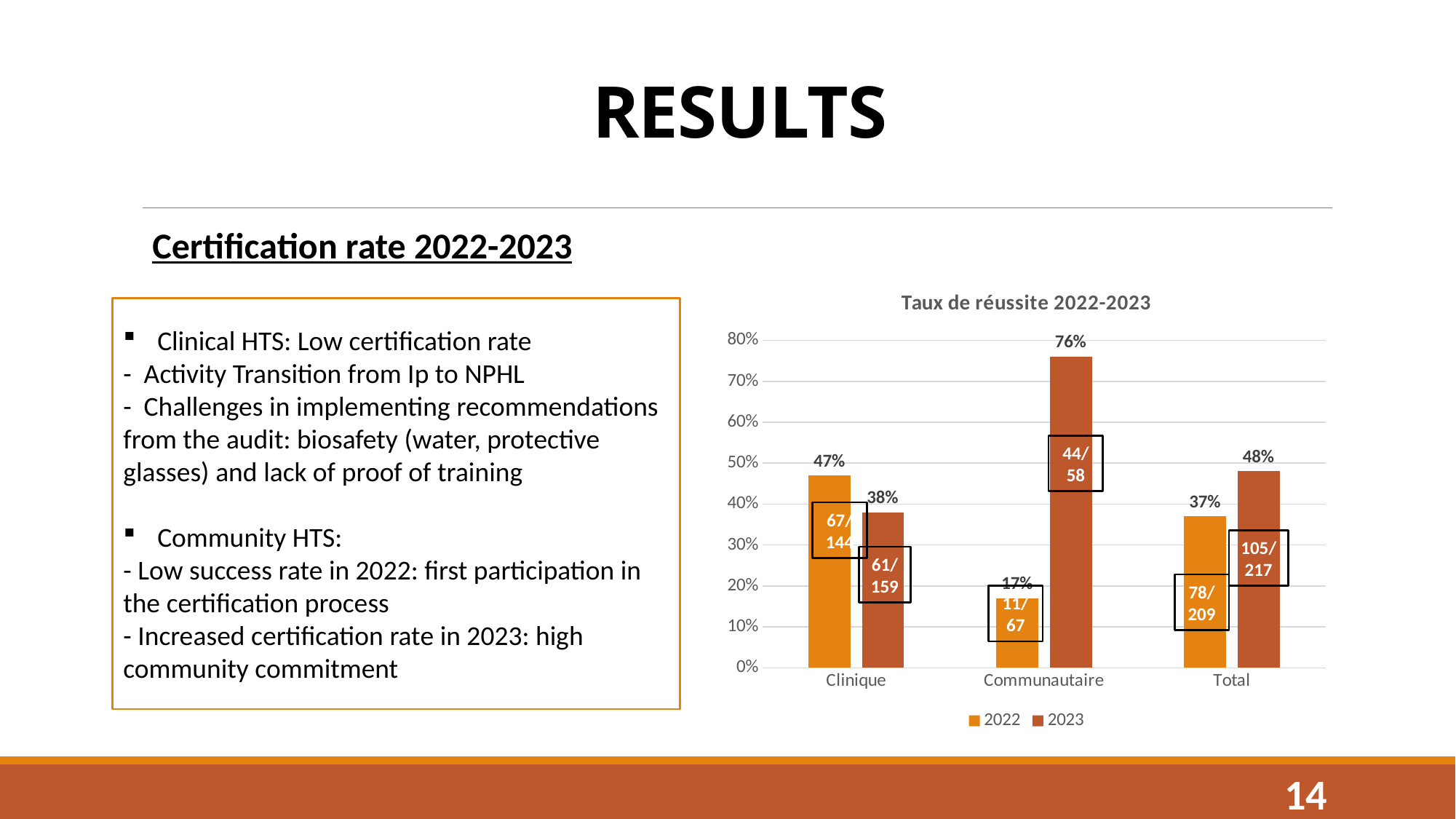
What is the 2022 value for Clinique? 47% What is the difference between the 2023 and 2022 values for Communautaire? 59% What is the title of the chart? Taux de réussite 2022-2023 What kind of chart is shown? Bar chart What is the 2022 value for Total? 37% Which category has the highest 2023 value? Communautaire What is the 2023 value for Clinique? 38% How many categories are shown on the x axis? 3 Which category has the lowest 2022 value? Communautaire What is the 2023 value for Communautaire? 76% How many series does the legend list? 2 Which is larger for Clinique, the 2022 value or the 2023 value? 2022